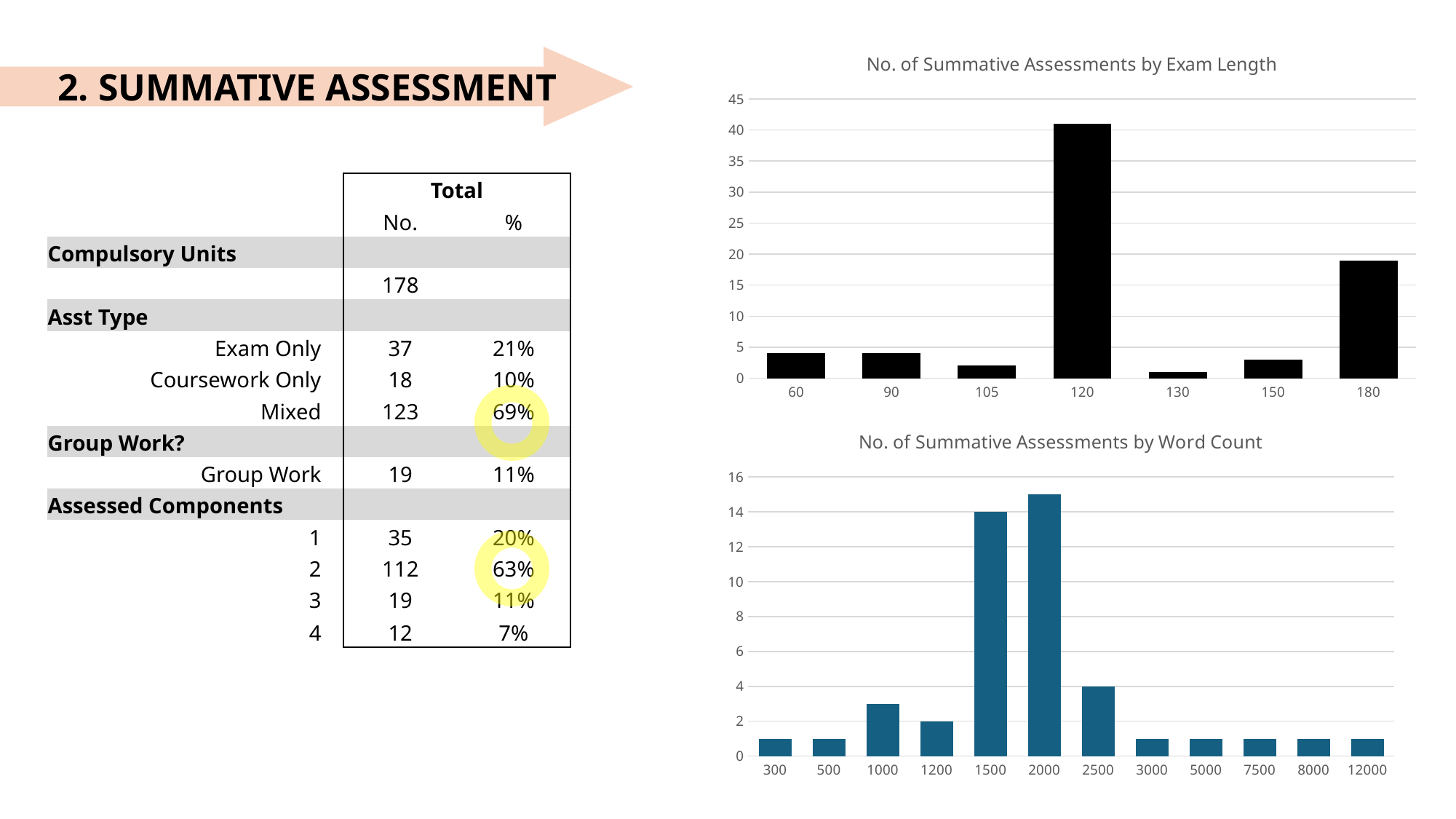
In the 'No. of Summative Assessments by Word Count' chart, what is the difference between the values for 1500 and 2500? 10 In the 'No. of Summative Assessments by Exam Length' chart, which exam length has the highest number of assessments? 120 What kind of chart is 'No. of Summative Assessments by Exam Length'? bar chart In the 'No. of Summative Assessments by Word Count' chart, how many assessments have a word count of 1500? 14 In the 'No. of Summative Assessments by Word Count' chart, how many assessments have a word count of 1200? 2 How many exam length categories are shown in the 'No. of Summative Assessments by Exam Length' chart? 7 In the 'No. of Summative Assessments by Word Count' chart, which word count has the highest number of assessments? 2000 How many word count categories are shown in the 'No. of Summative Assessments by Word Count' chart? 12 In the 'No. of Summative Assessments by Exam Length' chart, which has more assessments, 60 or 130? 60 In the 'No. of Summative Assessments by Word Count' chart, how many assessments have a word count of 2500? 4